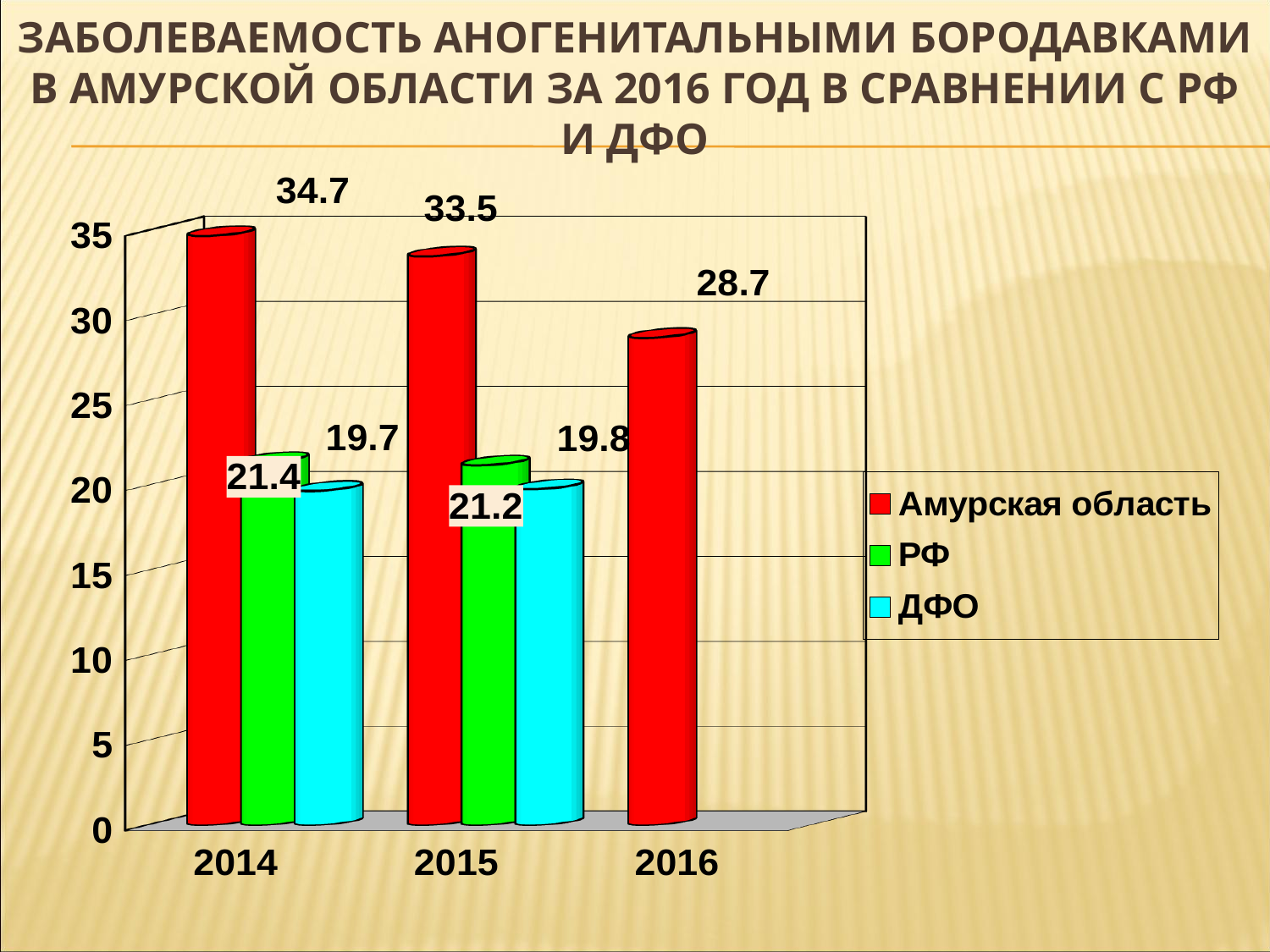
What is the value for Амурская область in 2016? 28.7 What is the value for ДФО in 2014? 19.7 How many series does the legend list? 3 What is the value for РФ in 2015? 21.2 Which is larger in 2015: the value for РФ or the value for ДФО? РФ Does the value for Амурская область rise or fall from 2014 to 2016? fall What kind of chart is shown on the slide? bar chart How many years are shown on the x axis? 3 In which year is the value for Амурская область lowest? 2016 What is the value for Амурская область in 2014? 34.7 In which year is the value for Амурская область highest? 2014 What is the difference between the Амурская область value and the РФ value in 2014? 13.3